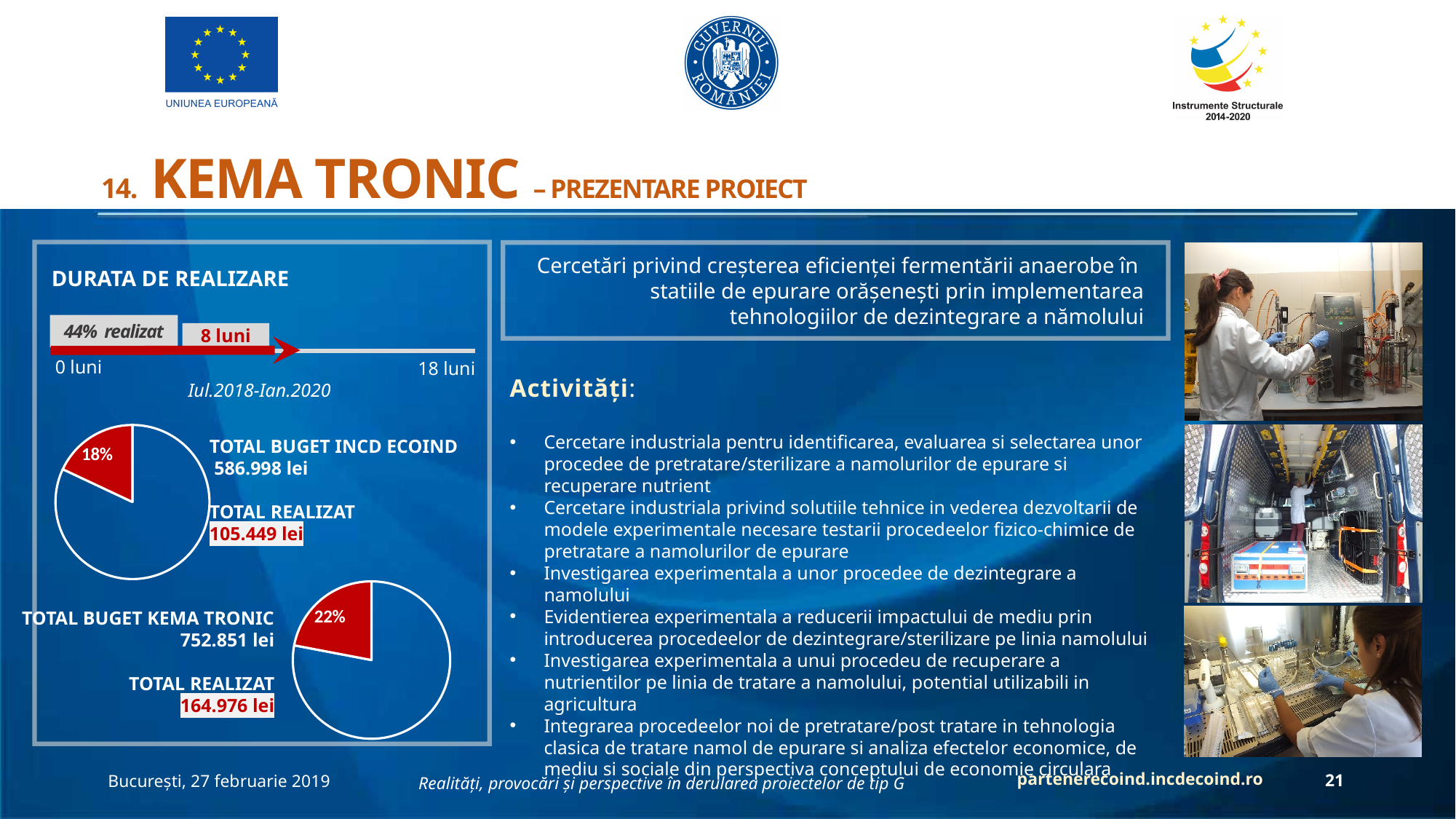
In the lower pie chart (TOTAL BUGET KEMA TRONIC), what share of the budget is shown as realized? 22% What is the TOTAL REALIZAT value shown next to the upper pie chart (INCD ECOIND)? 105.449 lei By how many percentage points does the realized share in the lower pie chart (22%) exceed the realized share in the upper pie chart (18%)? 4 percentage points What is the difference between TOTAL BUGET KEMA TRONIC (752.851 lei) and TOTAL BUGET INCD ECOIND (586.998 lei)? 165.853 lei What is the TOTAL BUGET INCD ECOIND value shown next to the upper pie chart? 586.998 lei In the upper pie chart (TOTAL BUGET INCD ECOIND), what share of the budget is shown as realized? 18% What colour is used for the realized slice in both pie charts? Red What is the TOTAL REALIZAT value shown next to the lower pie chart (KEMA TRONIC)? 164.976 lei Which pie chart shows the larger realized share: the upper one (INCD ECOIND) or the lower one (KEMA TRONIC)? The lower one (KEMA TRONIC) What is the TOTAL BUGET KEMA TRONIC value shown next to the lower pie chart? 752.851 lei What kind of charts are the two charts in the left panel of the slide? Pie charts How many pie charts are shown on the slide? 2